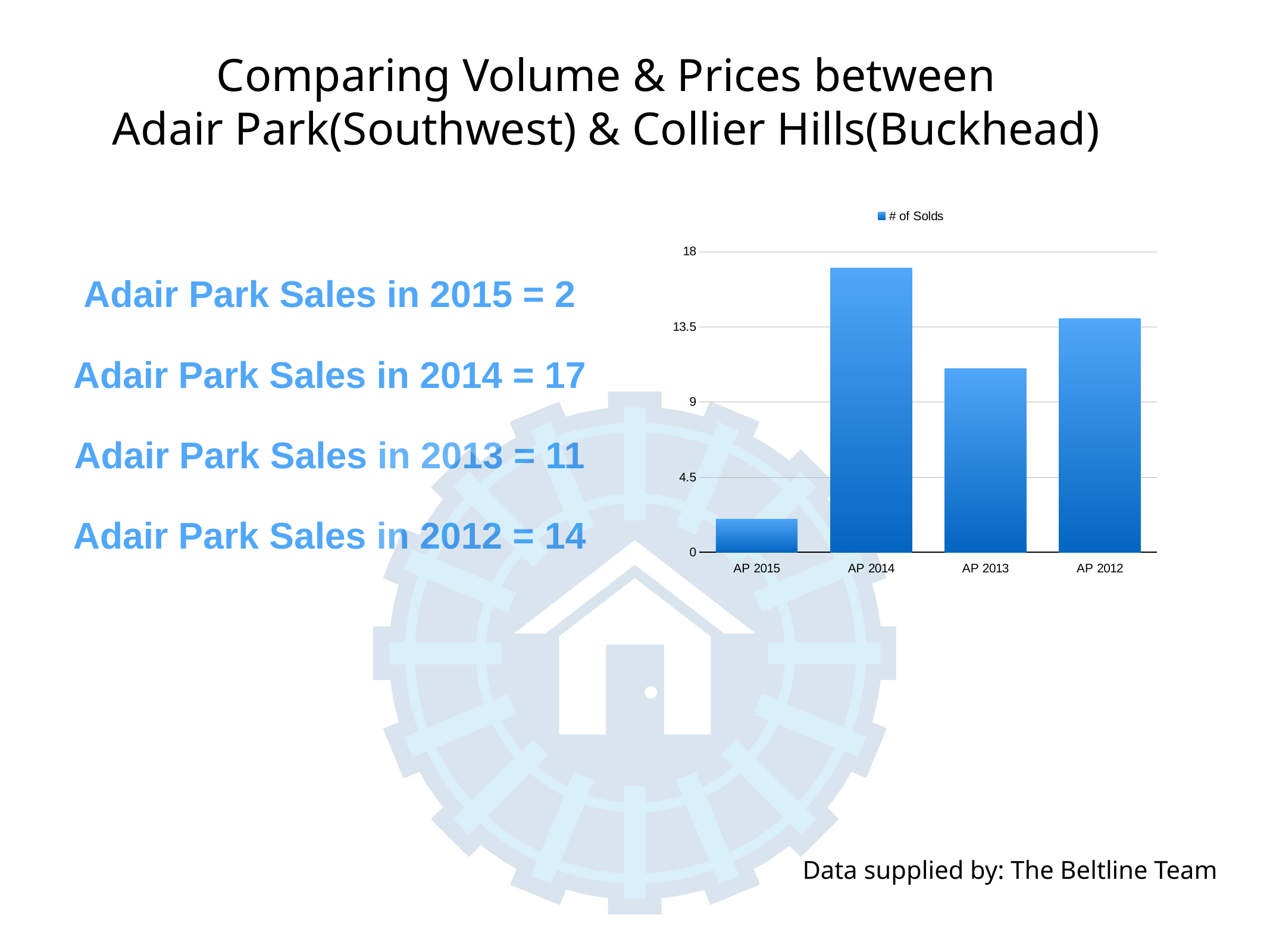
What kind of chart is shown on the slide? bar chart Which category has the highest number of solds in the chart? AP 2014 How many series does the chart legend list? 1 What is the difference in number of solds between AP 2014 and AP 2013? 6 How many categories are plotted on the x axis of the chart? 4 Which category has the lowest number of solds in the chart? AP 2015 Is the value for AP 2012 greater or less than 13.5? greater What is the number of solds for AP 2014? 17 Which has more solds, AP 2012 or AP 2013? AP 2012 What is the name of the series shown in the chart legend? # of Solds Is the value for AP 2015 greater or less than 4.5? less What is the number of solds for AP 2015? 2